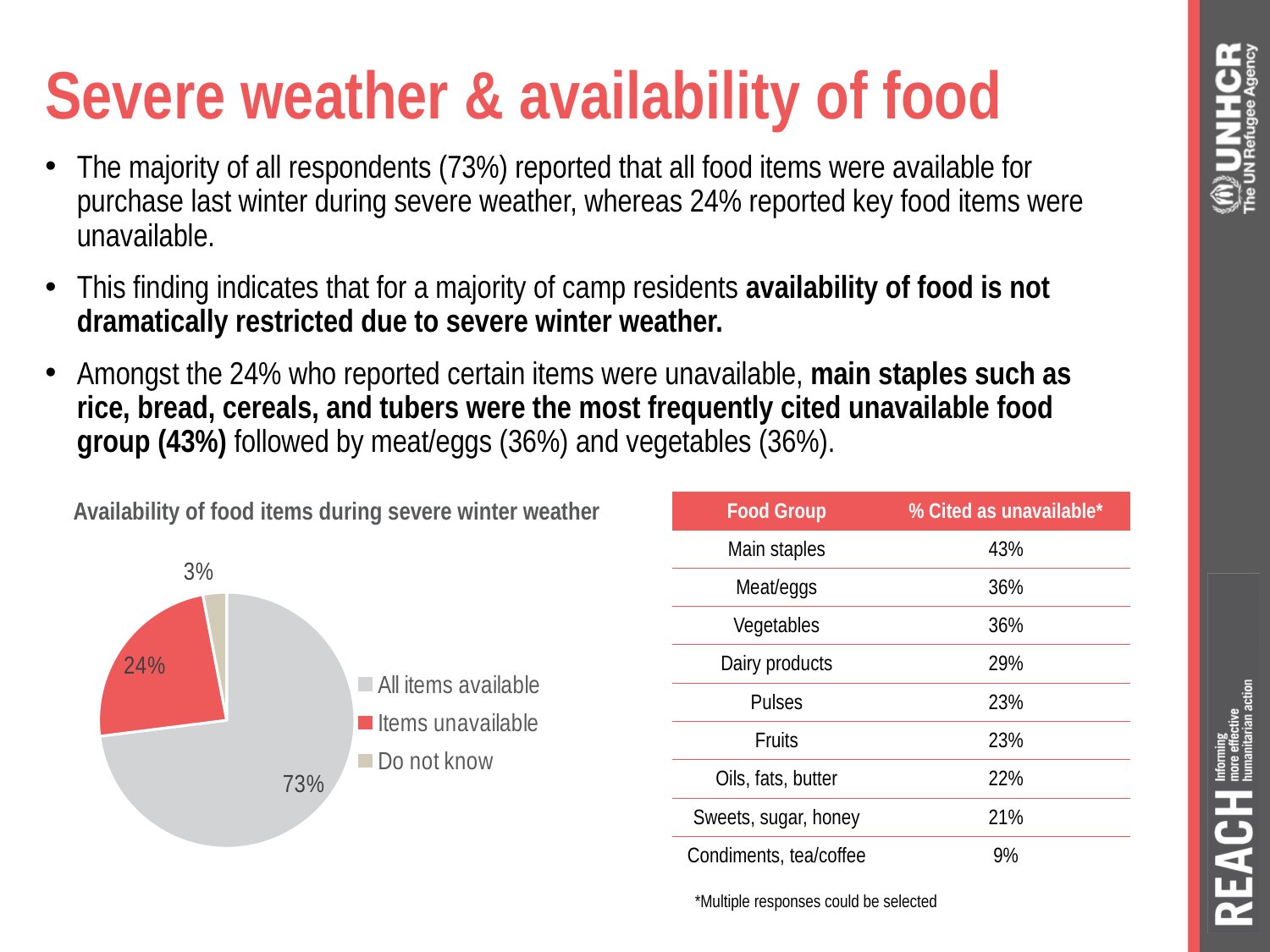
What share of the pie is labelled 'Do not know'? 3% What is the difference in percentage points between 'All items available' and 'Items unavailable'? 49 Which category has the largest slice of the pie? All items available What colour is the 'Items unavailable' slice in the pie chart? Red What share of the pie is labelled 'Items unavailable'? 24% What share of the pie is labelled 'All items available'? 73% Which category has the smallest slice of the pie? Do not know Which is larger: the 'Items unavailable' slice or the 'Do not know' slice? Items unavailable What is the title of the pie chart? Availability of food items during severe winter weather What type of chart is shown on the slide? Pie chart How many slices does the pie chart have? 3 How many entries does the pie chart's legend list? 3